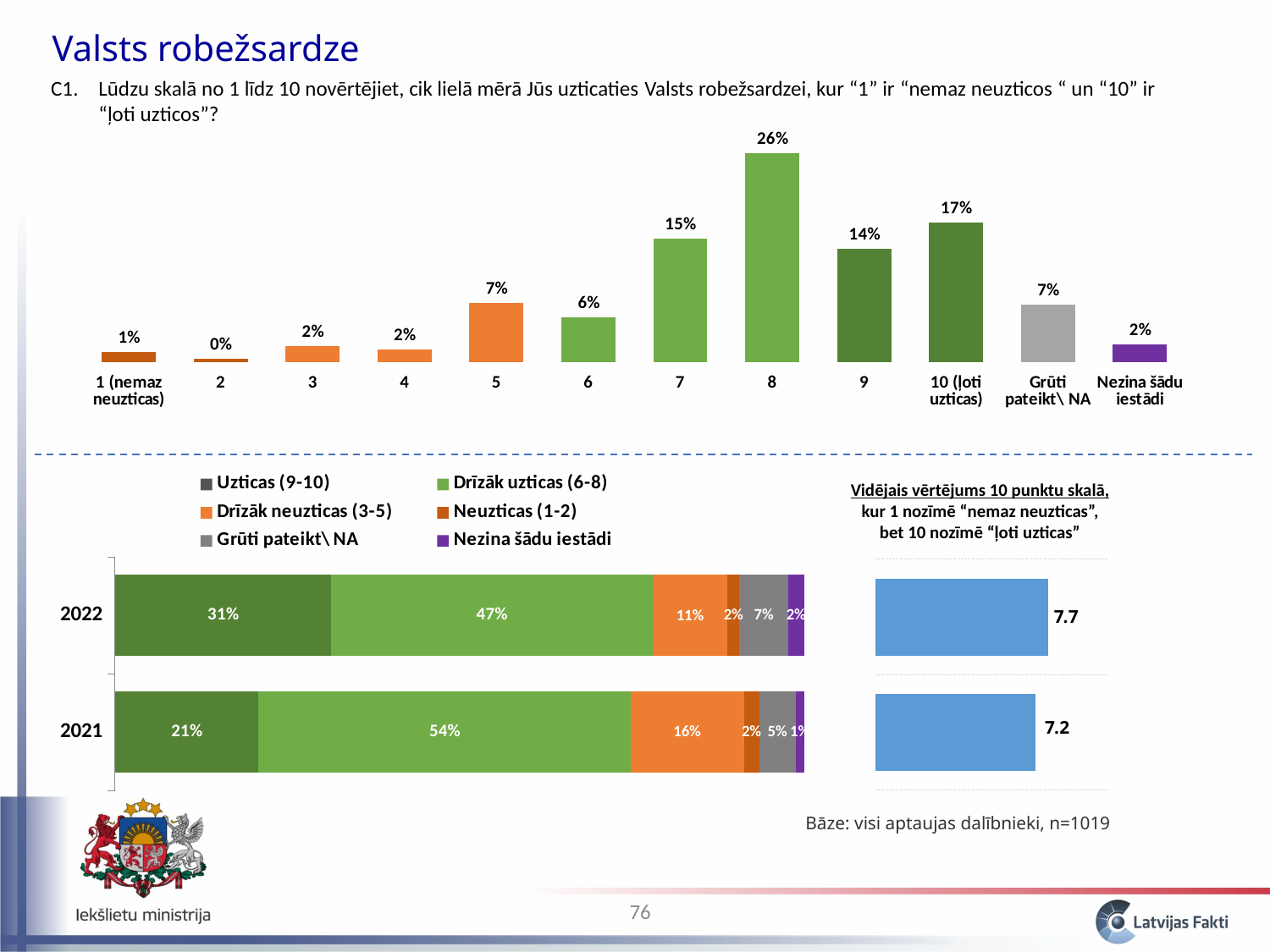
In the chart at the bottom right (Vidējais vērtējums 10 punktu skalā), what is the average rating for 2022? 7.7 In the top bar chart, what is the value for rating 8? 26% In the top bar chart, what is the difference between the values for rating 8 and rating 9? 12% What kind of chart is the chart at the bottom right showing the average rating? Bar chart In the stacked bar chart at the bottom left, what is the value of "Uzticas (9-10)" for 2022? 31% In the stacked bar chart at the bottom left, what is the difference between the "Drīzāk uzticas (6-8)" values for 2021 and 2022? 7% In the top bar chart, which is larger: the value for rating 7 or the value for rating 6? 7 In the top bar chart, how many categories are shown on the x axis? 12 In the stacked bar chart at the bottom left, how many series does the legend list? 6 In the top bar chart, which rating category has the highest value? 8 In the top bar chart, what is the value for "10 (ļoti uzticas)"? 17% In the stacked bar chart at the bottom left, what is the value of "Drīzāk neuzticas (3-5)" for 2021? 16%